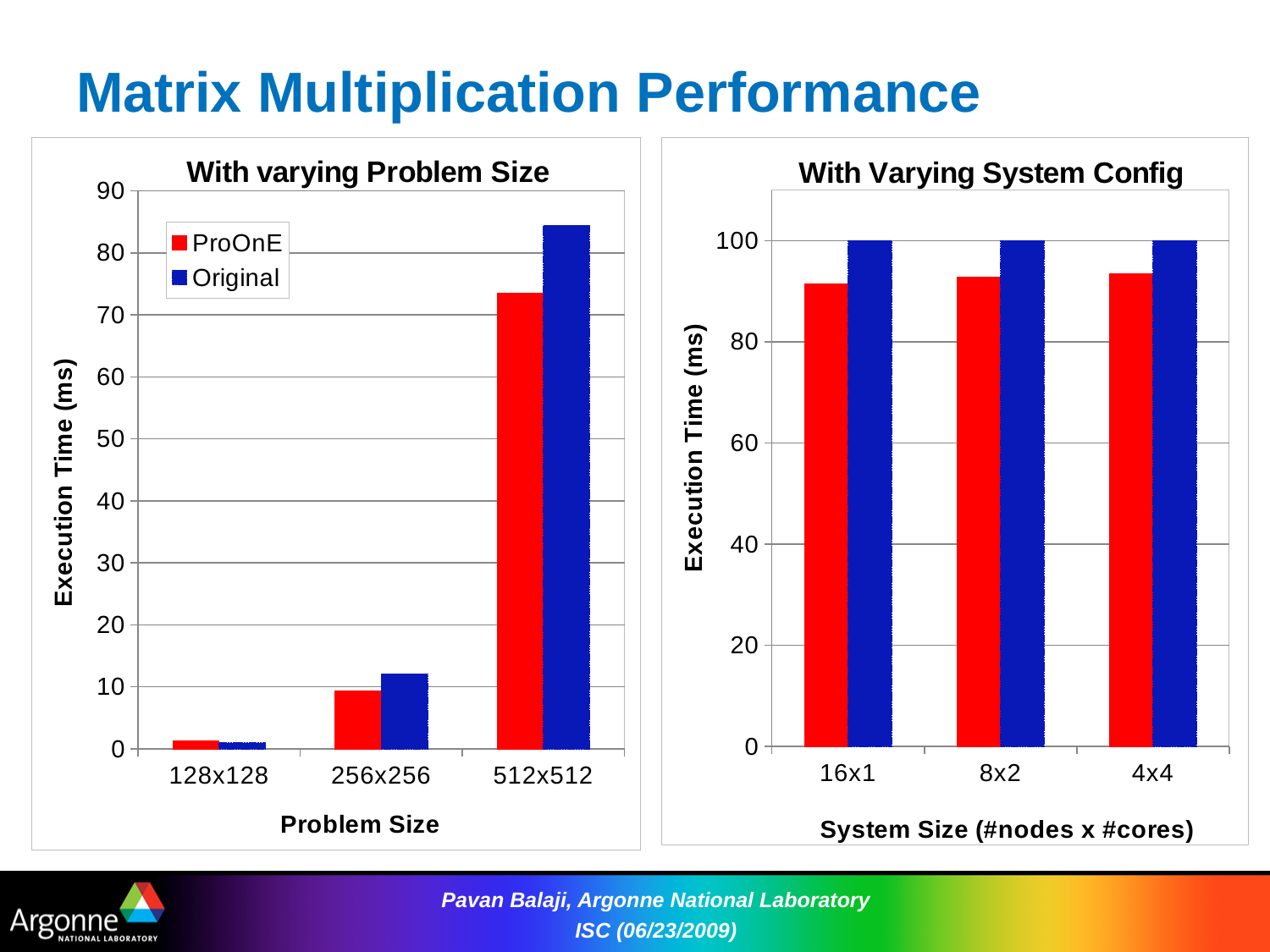
In the 'With varying Problem Size' chart, is the Original value for 512x512 greater or less than 80? greater How many series does the legend of the 'With varying Problem Size' chart list? 2 In the 'With varying Problem Size' chart, which problem size has the highest execution time for Original? 512x512 In the 'With varying Problem Size' chart, do the execution times rise or fall as the problem size increases along the x axis? rise What is the label of the y axis on the 'With Varying System Config' chart? Execution Time (ms) How many system configurations are shown on the x axis of the 'With Varying System Config' chart? 3 In the 'With varying Problem Size' chart, is the ProOnE value for 512x512 greater or less than 80? less In the 'With varying Problem Size' chart, which is larger at 512x512, ProOnE or Original? Original What kind of chart is the 'With varying Problem Size' chart? bar chart In the 'With varying Problem Size' chart, which problem size has the lowest execution time for ProOnE? 128x128 In the 'With Varying System Config' chart, is the ProOnE value for 16x1 greater or less than 80? greater How many problem sizes are shown on the x axis of the 'With varying Problem Size' chart? 3